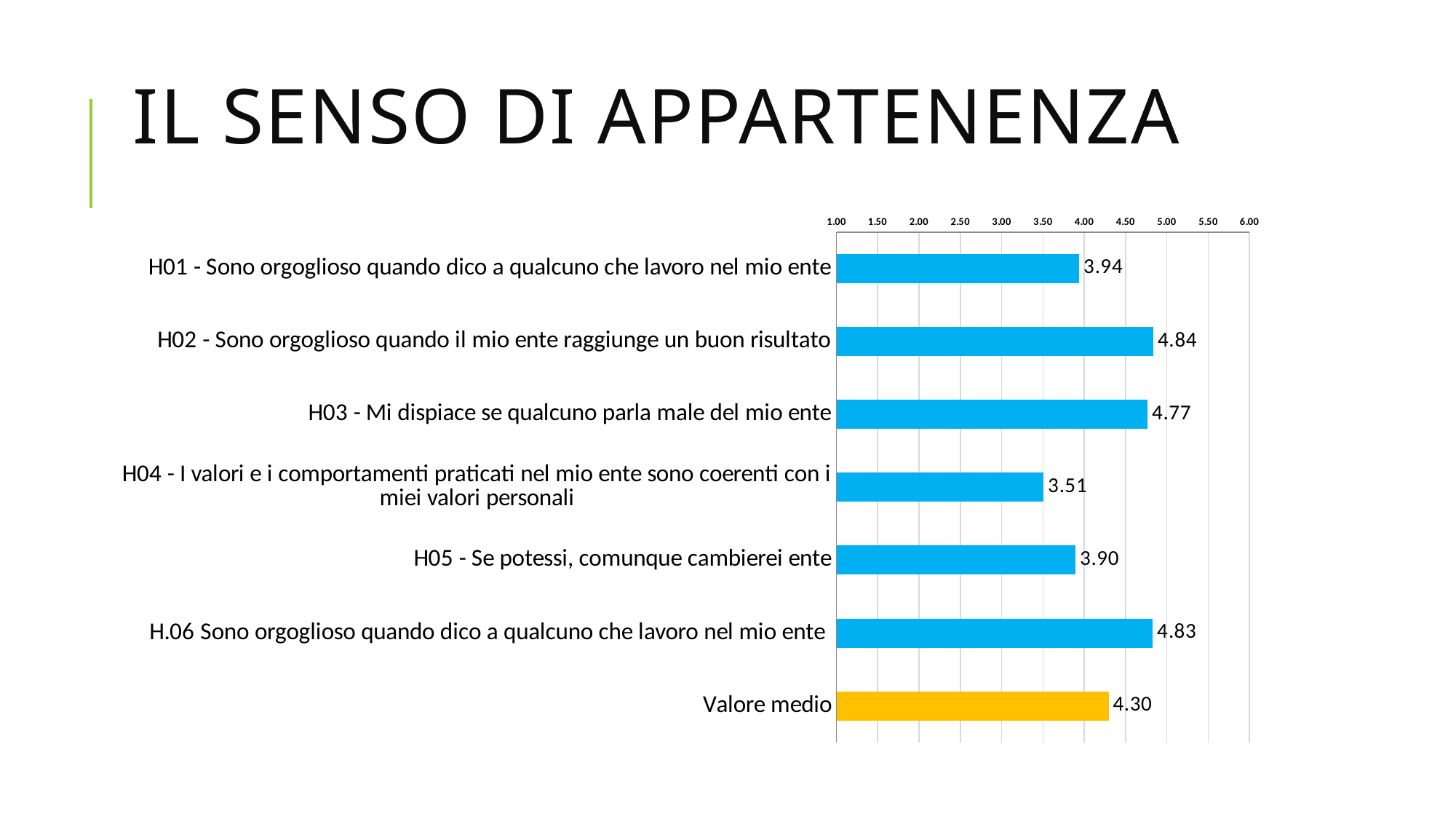
What is the value for H01 - Sono orgoglioso quando dico a qualcuno che lavoro nel mio ente? 3.94 What is the value for H04 - I valori e i comportamenti praticati nel mio ente sono coerenti con i miei valori personali? 3.51 What is the difference between the values for H03 and H05? 0.87 What is the value shown for Valore medio? 4.30 Which bar is coloured differently (yellow) from the others? Valore medio Which category has the lowest value? H04 - I valori e i comportamenti praticati nel mio ente sono coerenti con i miei valori personali How many bars are plotted in the chart? 7 What kind of chart is shown on the slide? Bar chart Which category has the highest value? H02 - Sono orgoglioso quando il mio ente raggiunge un buon risultato Which is larger, the value for H01 or the value for H05? H01 What is the difference between the values for H02 and H04? 1.33 Is the value for H04 greater or less than 4.00? less